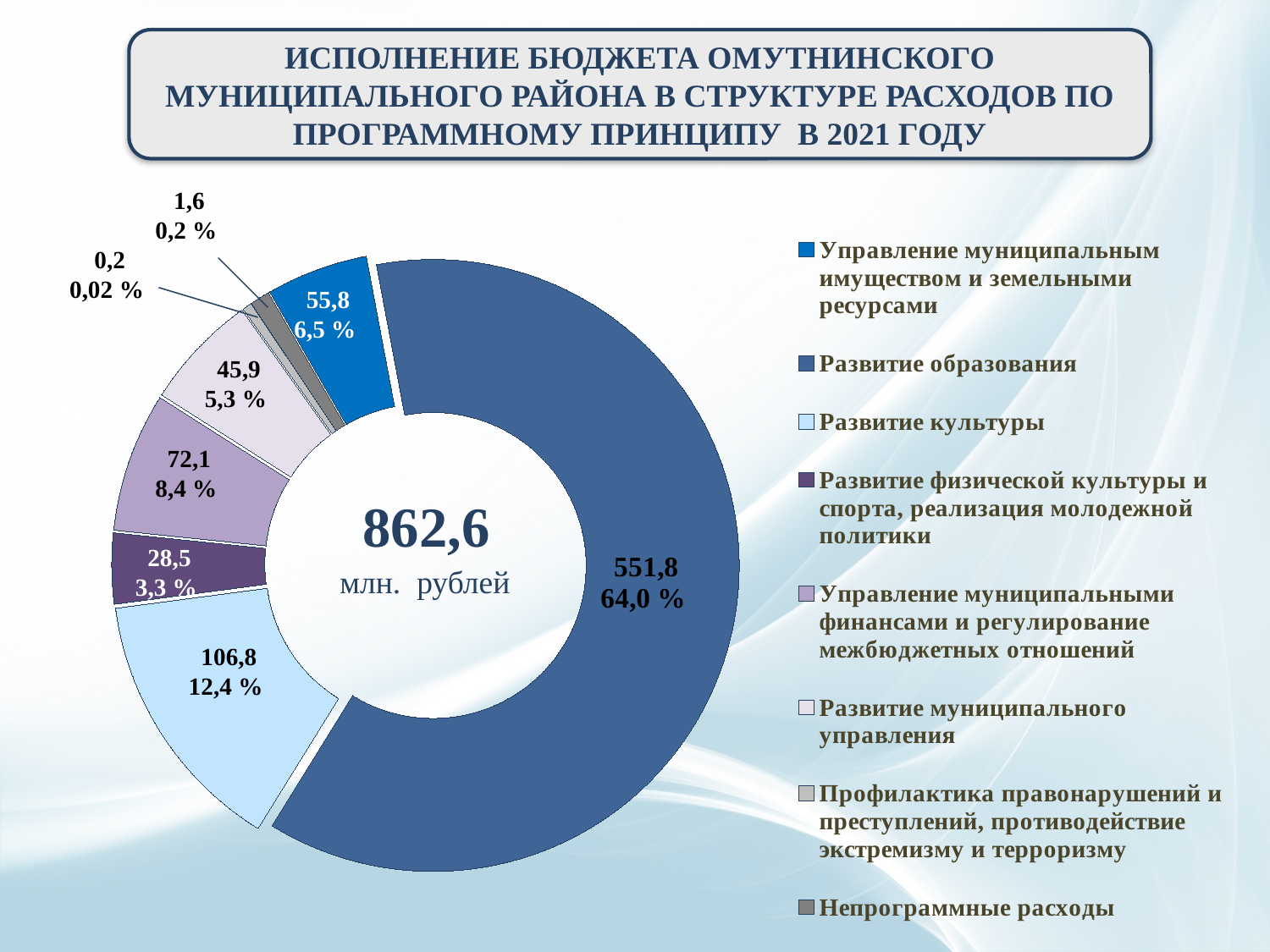
What kind of chart is shown on the slide? Pie (doughnut) chart Which is larger, the value for Развитие физической культуры и спорта, реализация молодежной политики or the value for Развитие муниципального управления? Развитие муниципального управления What is the smallest value labelled on the chart? 0,2 What percentage share is shown for Развитие физической культуры и спорта, реализация молодежной политики? 3,3 % What percentage share is shown for Развитие культуры? 12,4 % What value is shown for Управление муниципальными финансами и регулирование межбюджетных отношений? 72,1 What total is shown in the centre of the chart? 862,6 млн. рублей Which category has the largest slice of the chart? Развитие образования What percentage share is shown for Управление муниципальным имуществом и земельными ресурсами? 6,5 % What is the difference between the values for Развитие культуры and Развитие муниципального управления? 60,9 How many categories does the legend list? 8 What value is shown for Развитие образования? 551,8